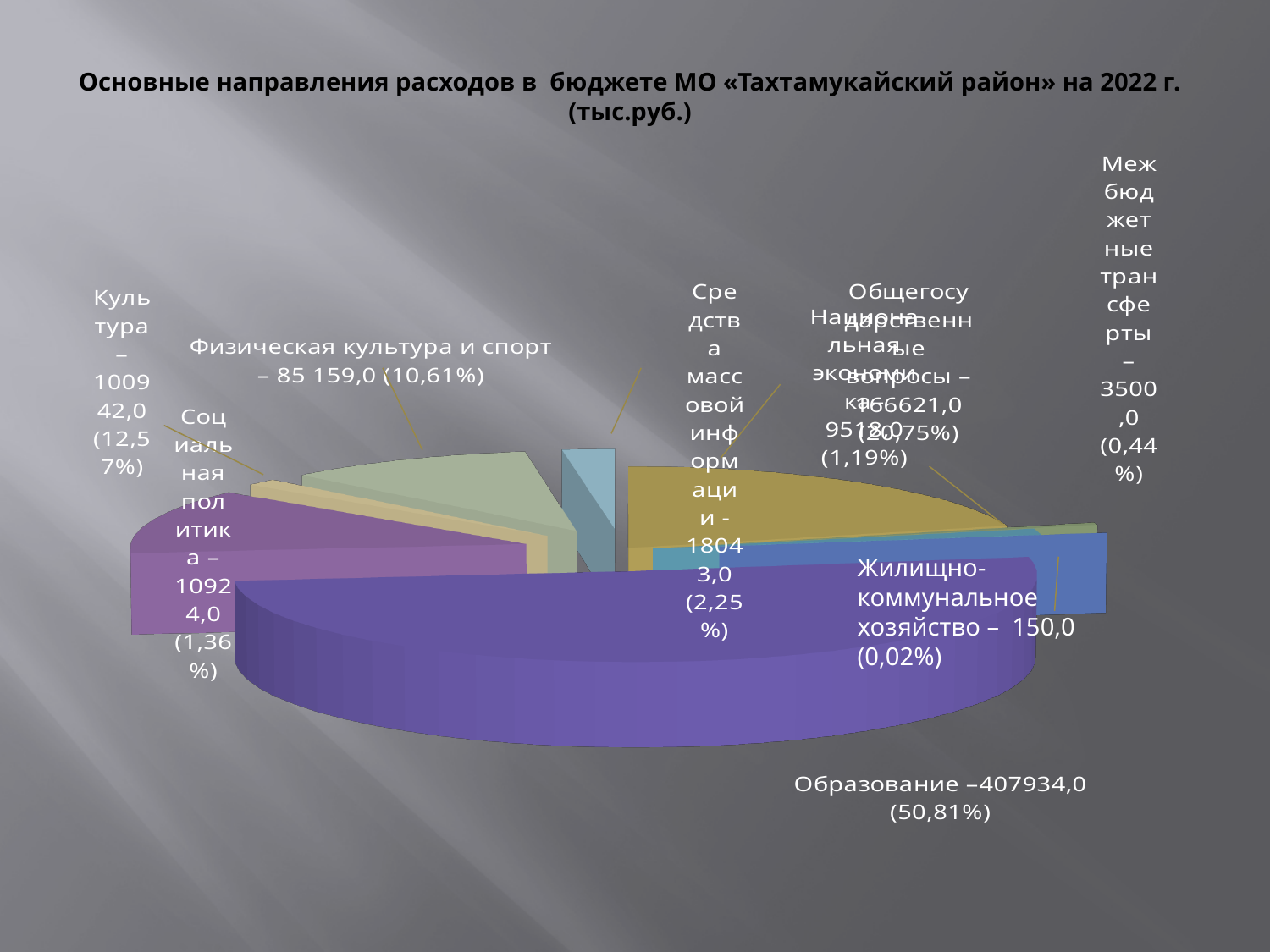
What is the value for Общегосударственные вопросы? 166621,0 How many categories are shown in the pie chart? 9 What share of the pie does Образование take? 50,81% What share of the pie does Межбюджетные трансферты take? 0,44% Which category has the smallest share of the pie? Жилищно-коммунальное хозяйство What share of the pie does Социальная политика take? 1,36% What is the value for Образование? 407934,0 Which category has the largest share of the pie? Образование What kind of chart is shown on the slide? pie chart What is the value for Средства массовой информации? 18043,0 What is the difference between the values for Культура and Физическая культура и спорт? 15783,0 Which is larger, Культура or Физическая культура и спорт? Культура